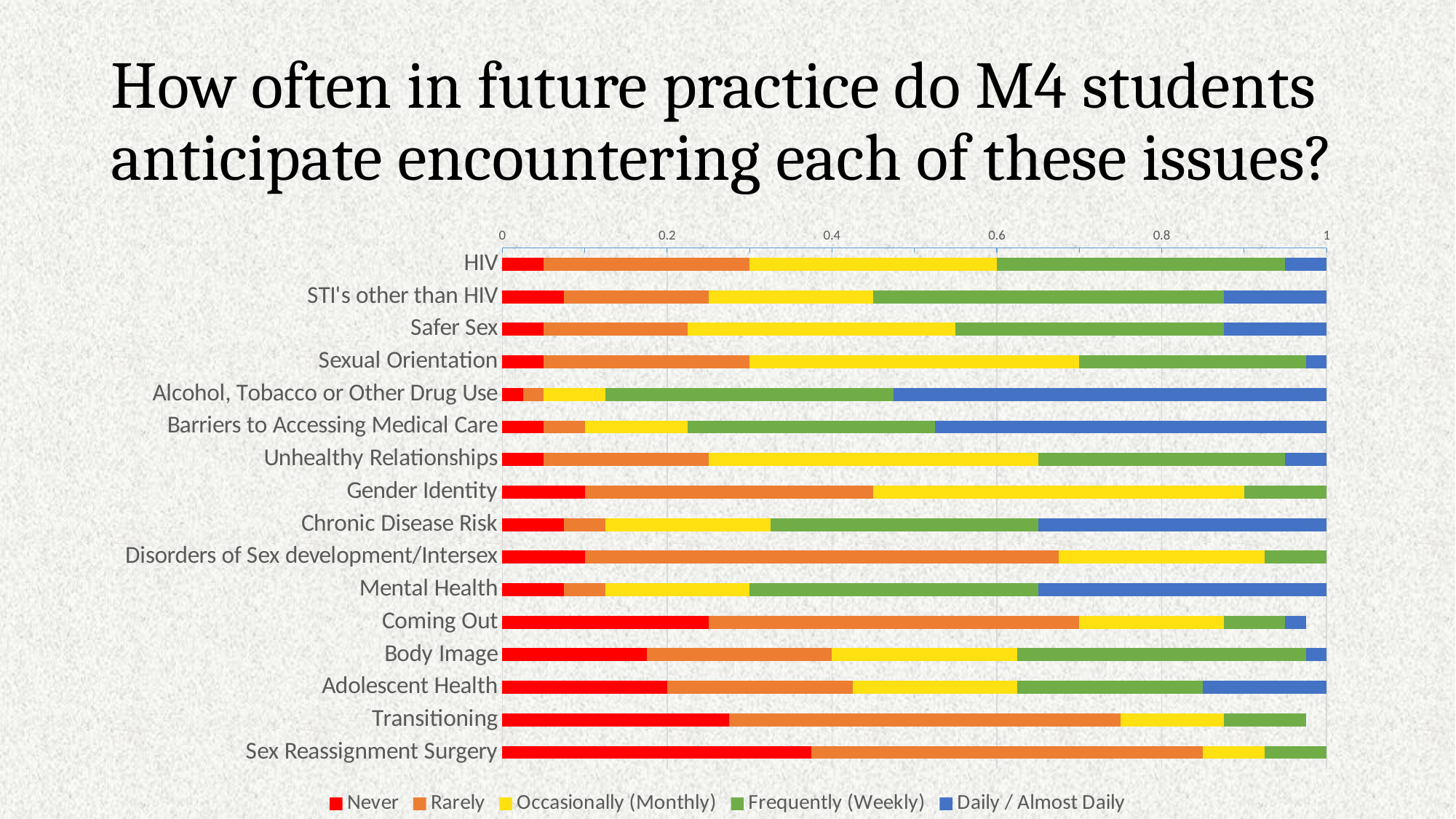
How many series does the legend list? 5 Is the 'Never' value for Sex Reassignment Surgery greater or less than 0.2? greater Which category has the smallest 'Never' segment? Alcohol, Tobacco or Other Drug Use What is the last entry in the legend? Daily / Almost Daily Which has the larger 'Never' segment, Sex Reassignment Surgery or Transitioning? Sex Reassignment Surgery Which series is shown in red? Never Which has the larger 'Never' segment, Coming Out or HIV? Coming Out Is the 'Never' value for Transitioning greater or less than 0.2? greater Which category has the largest 'Never' segment? Sex Reassignment Surgery Is the 'Never' value for HIV greater or less than 0.2? less What kind of chart is shown on the slide? Stacked bar chart How many issue categories are listed on the chart? 16